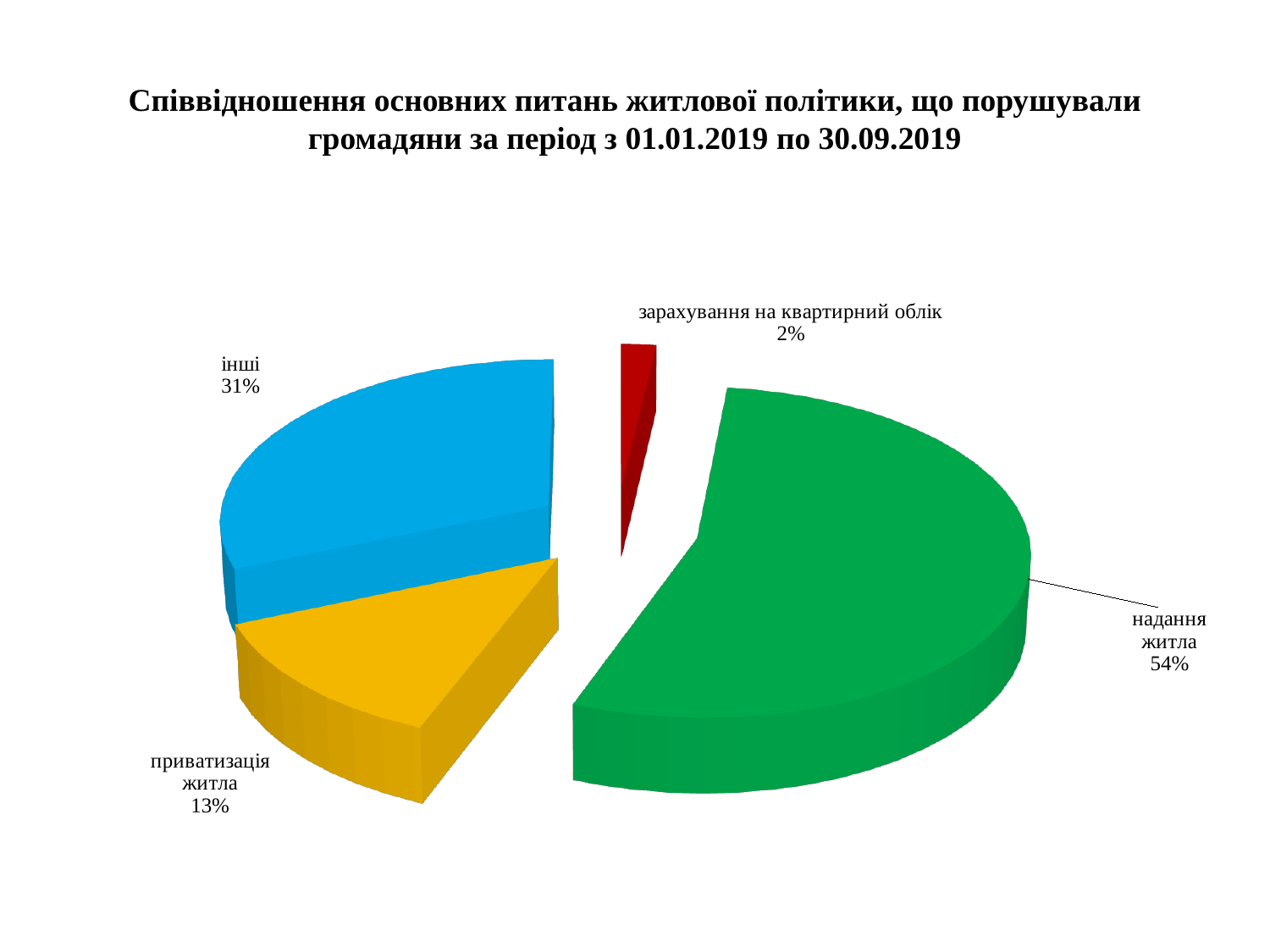
What share of the pie does "приватизація житла" have? 13% What share of the pie does "надання житла" have? 54% What is the difference in percentage points between "приватизація житла" and "зарахування на квартирний облік"? 11 How many slices does the pie chart have? 4 What kind of chart is shown on the slide? pie chart What is the difference in percentage points between "надання житла" and "інші"? 23 What share of the pie does "зарахування на квартирний облік" have? 2% Which is larger: the share for "інші" or the share for "приватизація житла"? інші Which category has the smallest slice of the pie? зарахування на квартирний облік Which category has the largest slice of the pie? надання житла What colour is the slice for "надання житла"? green